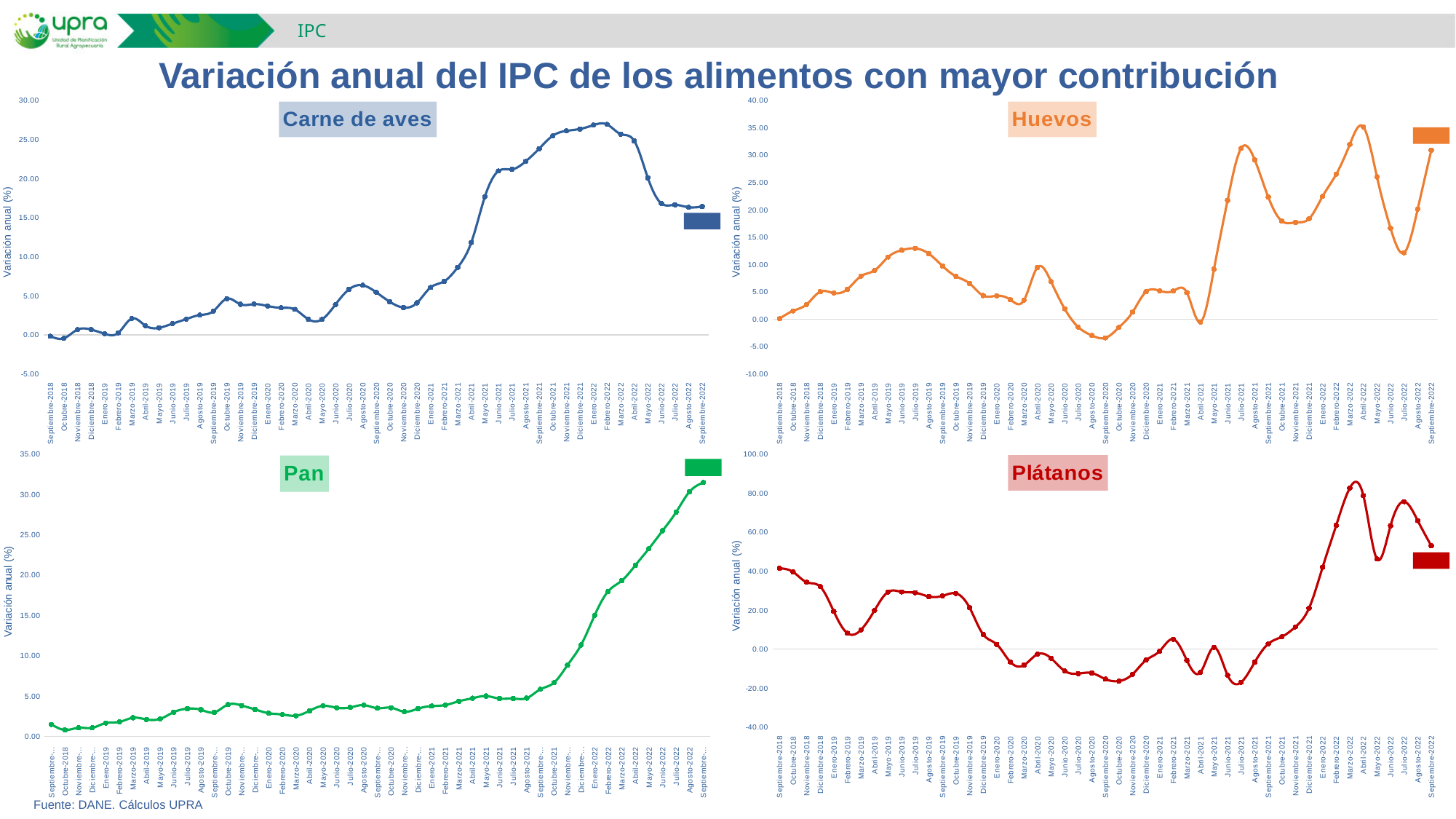
In the Huevos chart, is the value for Agosto-2020 greater or less than 0.00? less In the Carne de aves chart, is the value for Septiembre-2022 greater or less than 15.00? greater What kind of chart is the Carne de aves chart? line chart In the Pan chart, is the value for Septiembre-2022 greater or less than 25.00? greater In the Carne de aves chart, do the values rise or fall from Febrero-2022 to Septiembre-2022? fall In the Pan chart, do the values rise or fall from Agosto-2021 to Septiembre-2022? rise How many charts are shown on the slide? 4 In the Plátanos chart, which is larger, the value for Septiembre-2018 or the value for Septiembre-2022? Septiembre-2022 What colour is the line in the Huevos chart? orange